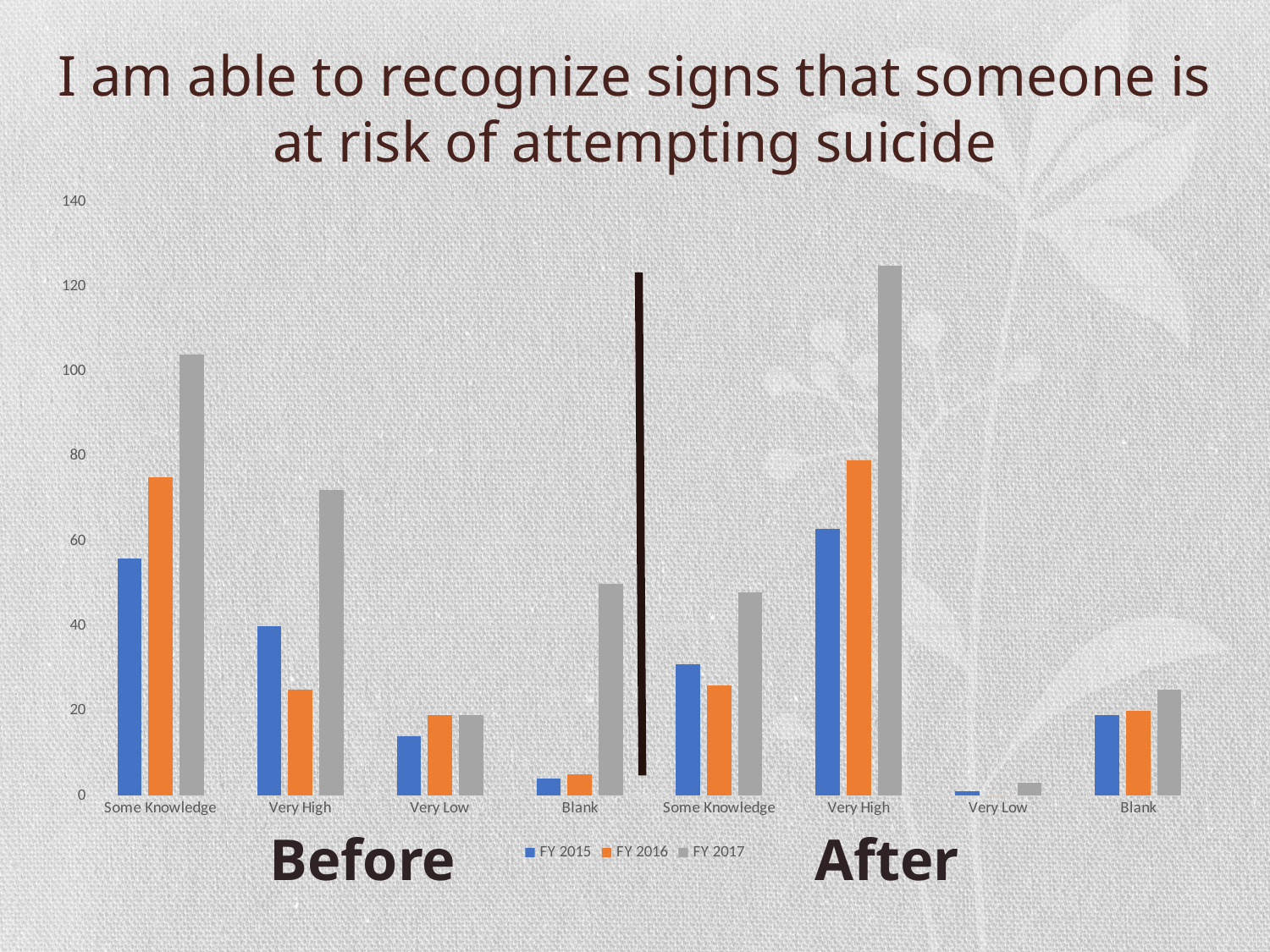
For Very High in the Before section, which is larger: the FY 2015 bar or the FY 2016 bar? FY 2015 How many series does the legend list? 3 Is the FY 2017 value for Very High in the After section greater or less than 120? greater Is the FY 2015 value for Blank in the Before section greater or less than 20? less Which category and series has the tallest bar on the whole chart? Very High (After), FY 2017 Is the FY 2017 value for Some Knowledge in the Before section greater or less than 100? greater What kind of chart is shown on the slide? bar chart How many categories are shown along the x axis? 8 Which series has the tallest bar for Some Knowledge in the Before section? FY 2017 Which is larger: the FY 2017 bar for Some Knowledge (Before) or the FY 2017 bar for Very High (After)? Very High (After) What are the two section labels printed below the chart? Before and After